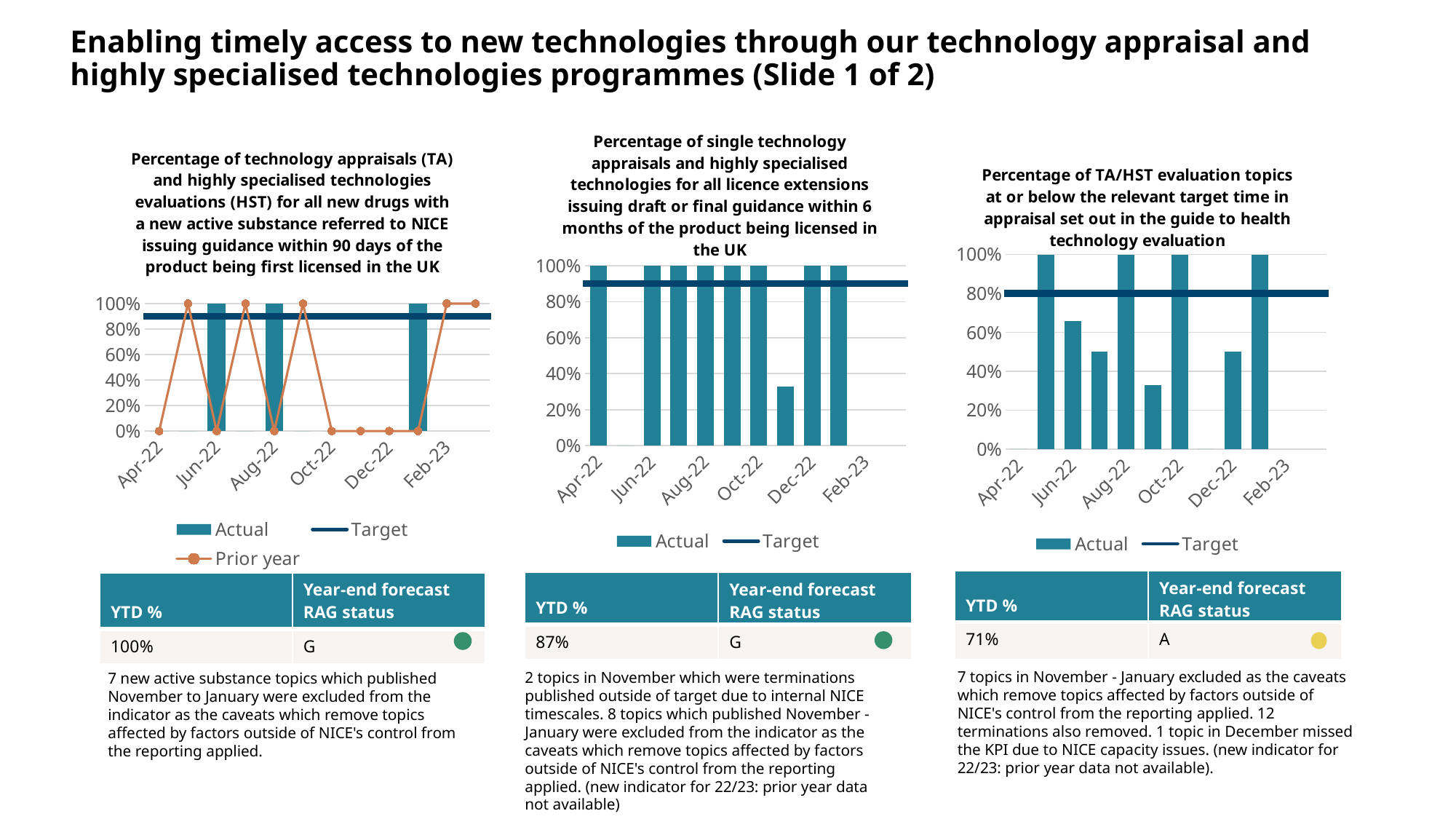
In the left chart (Percentage of technology appraisals (TA) and HST evaluations for new drugs), how many series does the legend list? 3 In the right chart (Percentage of TA/HST evaluation topics at or below the relevant target time), what value is the Target line at? 80% In the left chart (Percentage of technology appraisals (TA) and HST evaluations for new drugs), what is the Prior year value for Apr-22? 0% In the middle chart (Percentage of single technology appraisals and HST for licence extensions), what is the Actual value for Apr-22? 100% In the left chart (Percentage of technology appraisals (TA) and HST evaluations for new drugs), what are the legend entries? Actual, Target, Prior year In the right chart (Percentage of TA/HST evaluation topics at or below the relevant target time), which is larger, the Actual value for Jun-22 or for Jul-22? Jun-22 In the middle chart (Percentage of single technology appraisals and HST for licence extensions), how many series does the legend list? 2 In the middle chart (Percentage of single technology appraisals and HST for licence extensions), is the Actual value for Nov-22 greater or less than 40%? less In the right chart (Percentage of TA/HST evaluation topics at or below the relevant target time), how many Actual bars are plotted? 8 What kind of chart is the middle chart (Percentage of single technology appraisals and HST for licence extensions)? bar chart In the right chart (Percentage of TA/HST evaluation topics at or below the relevant target time), is the Actual value for Jun-22 greater or less than 60%? greater